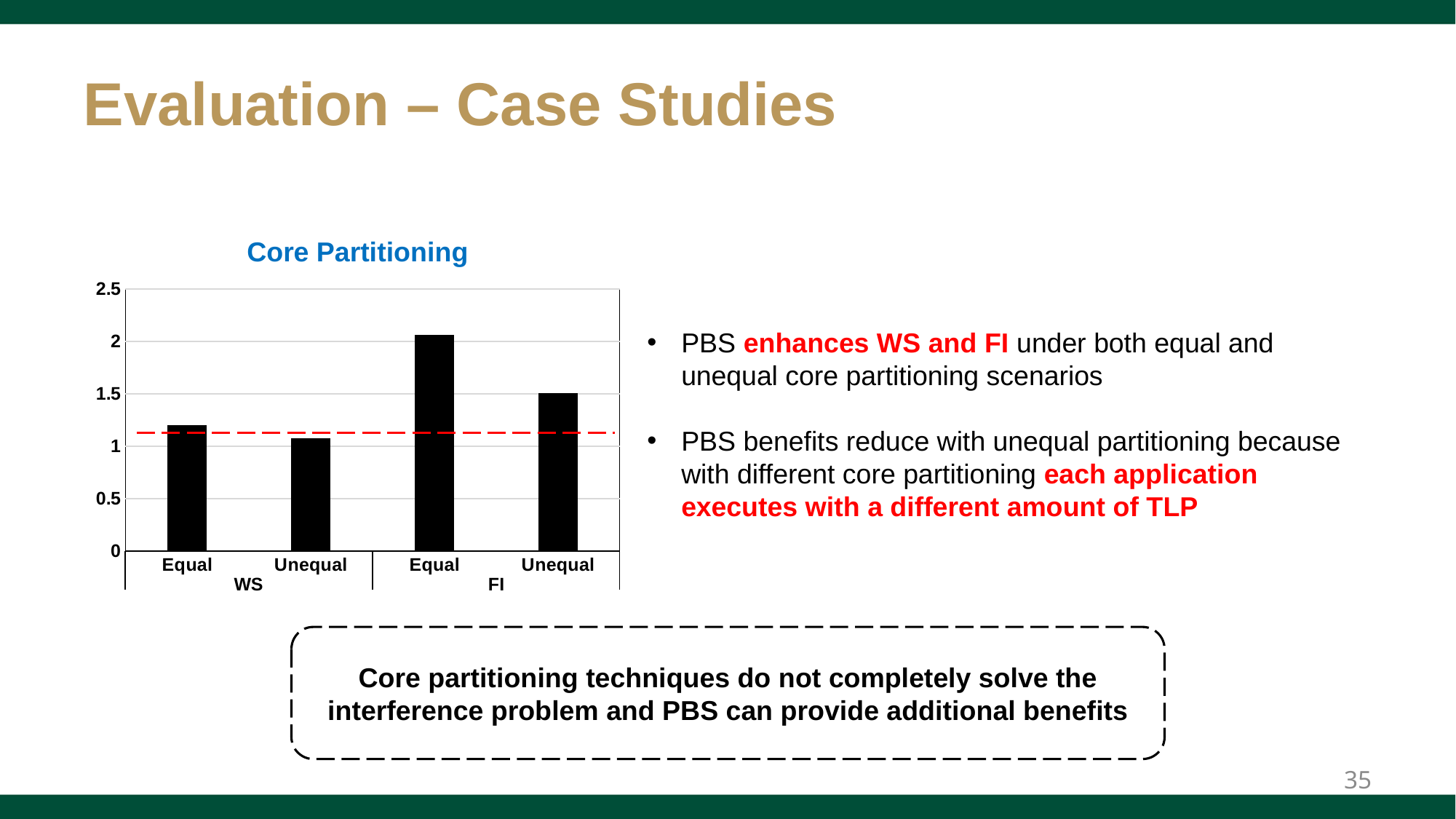
Which bar is the lowest in the Core Partitioning chart? WS Unequal What colour are the bars in the Core Partitioning chart? black Which bar is the highest in the Core Partitioning chart? FI Equal In the Core Partitioning chart, which is larger: FI Equal or FI Unequal? FI Equal Is the value for FI Unequal in the Core Partitioning chart greater or less than 1? greater How many groups are labelled on the x axis of the Core Partitioning chart? 2 What is the highest tick value shown on the y axis of the Core Partitioning chart? 2.5 In the Core Partitioning chart, which is larger: WS Equal or WS Unequal? WS Equal How many bars are plotted in the Core Partitioning chart? 4 Is the value for FI Equal in the Core Partitioning chart greater or less than 1.5? greater Is the value for WS Unequal in the Core Partitioning chart greater or less than 1.5? less What kind of chart is shown under the title "Core Partitioning"? bar chart